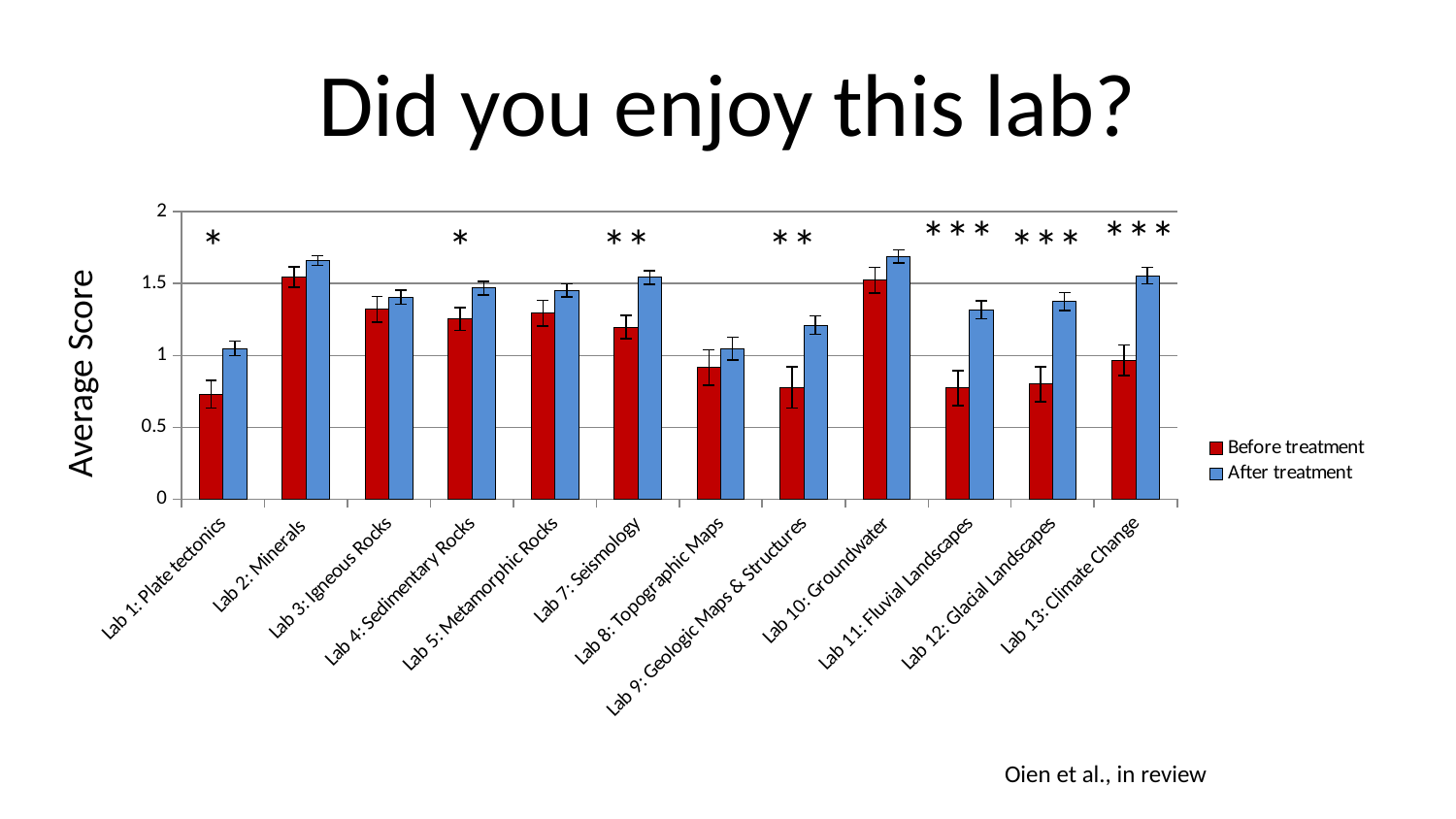
What kind of chart is shown on the slide? bar chart Is the After treatment value for Lab 10: Groundwater greater or less than 1.5? greater Is the After treatment value for Lab 11: Fluvial Landscapes greater or less than 1? greater What is the title of the chart? Did you enjoy this lab? How many lab categories are shown on the x axis? 12 Is the Before treatment value for Lab 9: Geologic Maps & Structures greater or less than 1? less How many series does the legend list? 2 For Lab 1: Plate tectonics, which is larger, the Before treatment value or the After treatment value? After treatment What is the label on the y axis? Average Score Which is larger, the Before treatment value for Lab 2: Minerals or the Before treatment value for Lab 12: Glacial Landscapes? Lab 2: Minerals